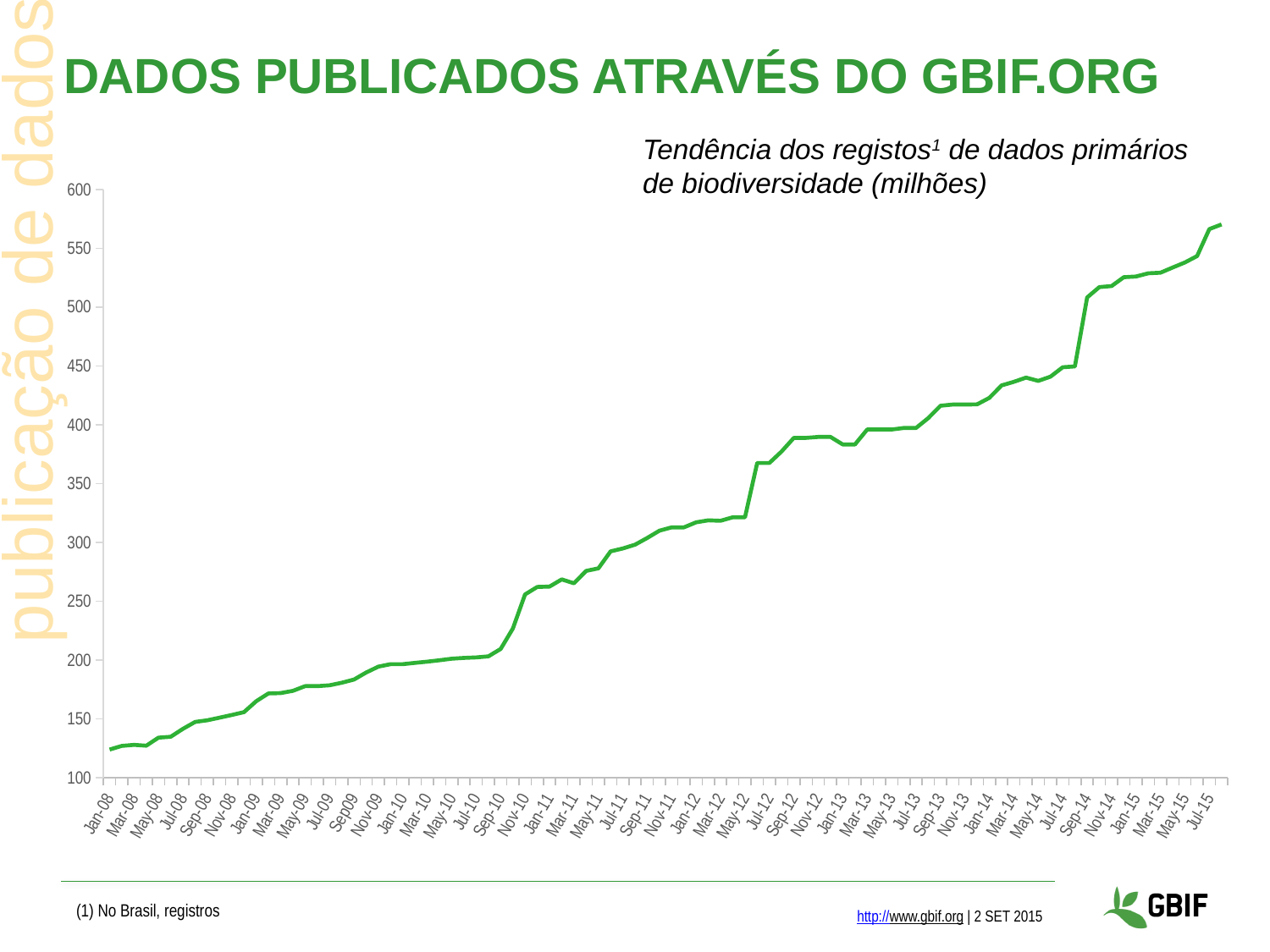
Do the values rise or fall along the x axis from Jan-08 to Jul-15? rise Is the value for Jan-14 greater or less than 400? greater Is the value for Jul-12 greater or less than 350? greater Is the value for Jul-15 greater or less than 550? greater What unit does the chart title say the records are measured in? milhões What kind of chart is shown on the slide? line chart Which is larger, the value for Jan-12 or the value for Jul-12? Jul-12 Which month on the x axis has the lowest value? Jan-08